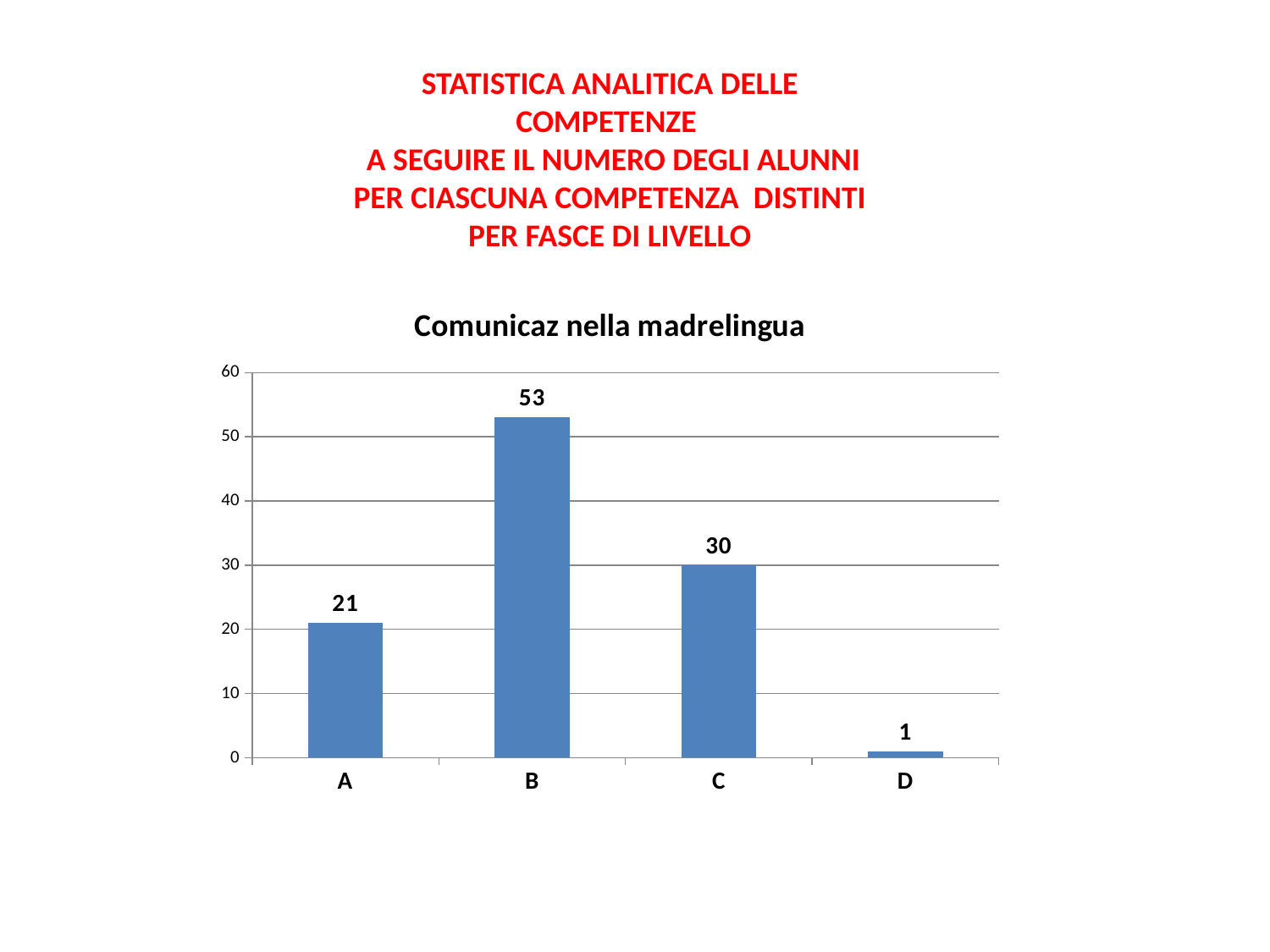
What is the title of the chart? Comunicaz nella madrelingua What is the difference between the values for B and C? 23 How many categories are shown on the x axis? 4 What kind of chart is shown? bar chart What is the value for category B? 53 What is the difference between the values for A and D? 20 Which category has the highest value? B What is the value for category D? 1 Is the value for B greater or less than 50? greater Which category has the lowest value? D Which is larger, the value for A or the value for C? C What is the value for category A? 21